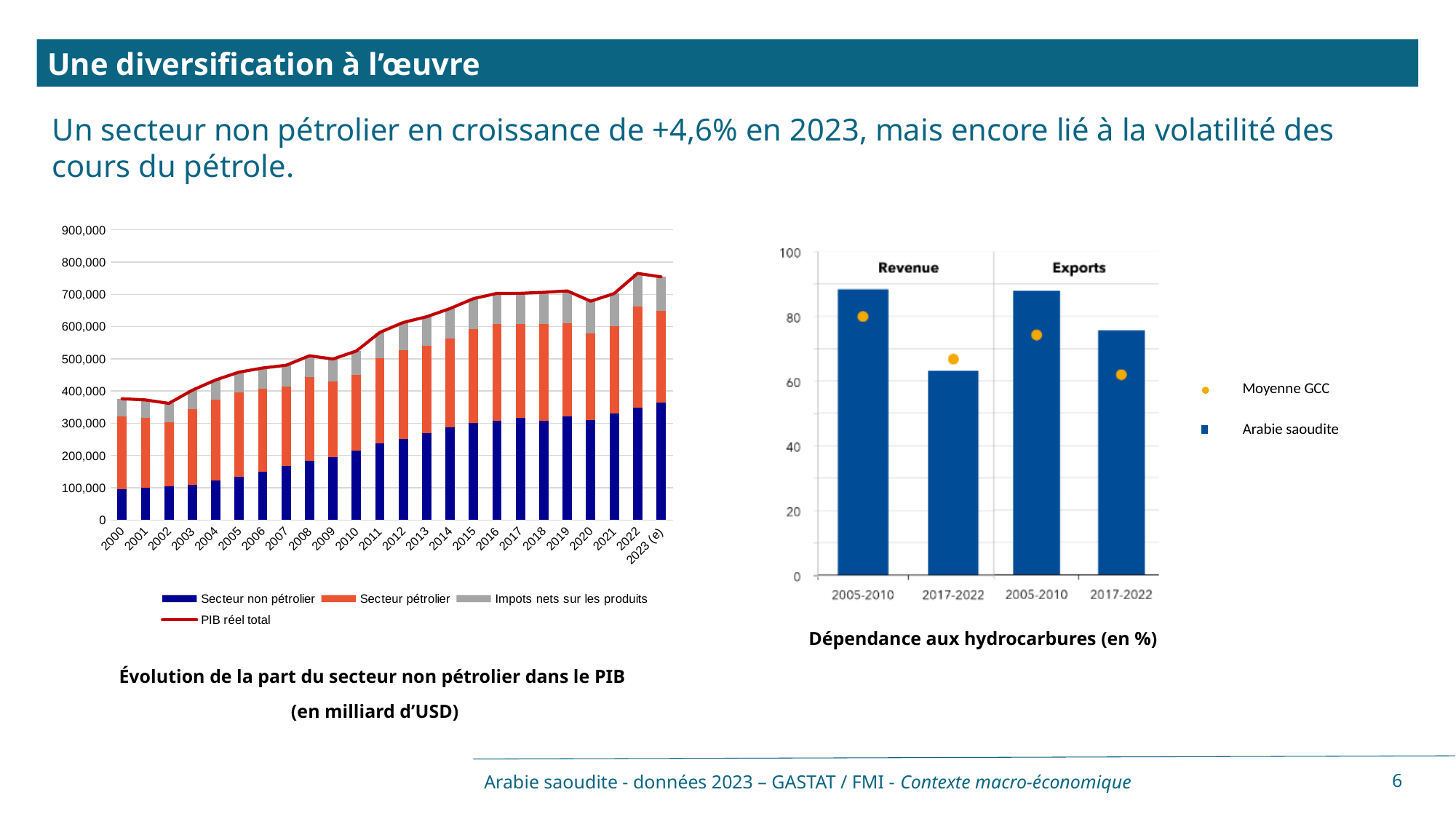
In the left chart, does the 'Secteur non pétrolier' series rise or fall from 2000 to 2023 (e)? Rise In the left chart, is the 'Secteur non pétrolier' value for 2023 (e) greater or less than 300,000? greater What is the title of the right chart? Dépendance aux hydrocarbures (en %) How many series does the legend of the left chart list? 4 What kind of chart is the left chart, 'Évolution de la part du secteur non pétrolier dans le PIB'? Stacked bar chart with a line In the right chart 'Dépendance aux hydrocarbures', for Revenue 2017-2022, which is larger: Arabie saoudite or Moyenne GCC? Moyenne GCC In the left chart, is the 'PIB réel total' value for 2022 greater or less than 700,000? greater In the right chart 'Dépendance aux hydrocarbures', is the Arabie saoudite value for Revenue 2017-2022 greater or less than 80? less How many series does the legend of the right chart 'Dépendance aux hydrocarbures' list? 2 How many years are shown on the x axis of the left chart? 24 In the left chart, which series is drawn as a red line? PIB réel total In the right chart 'Dépendance aux hydrocarbures', which Arabie saoudite bar is the lowest? Revenue 2017-2022